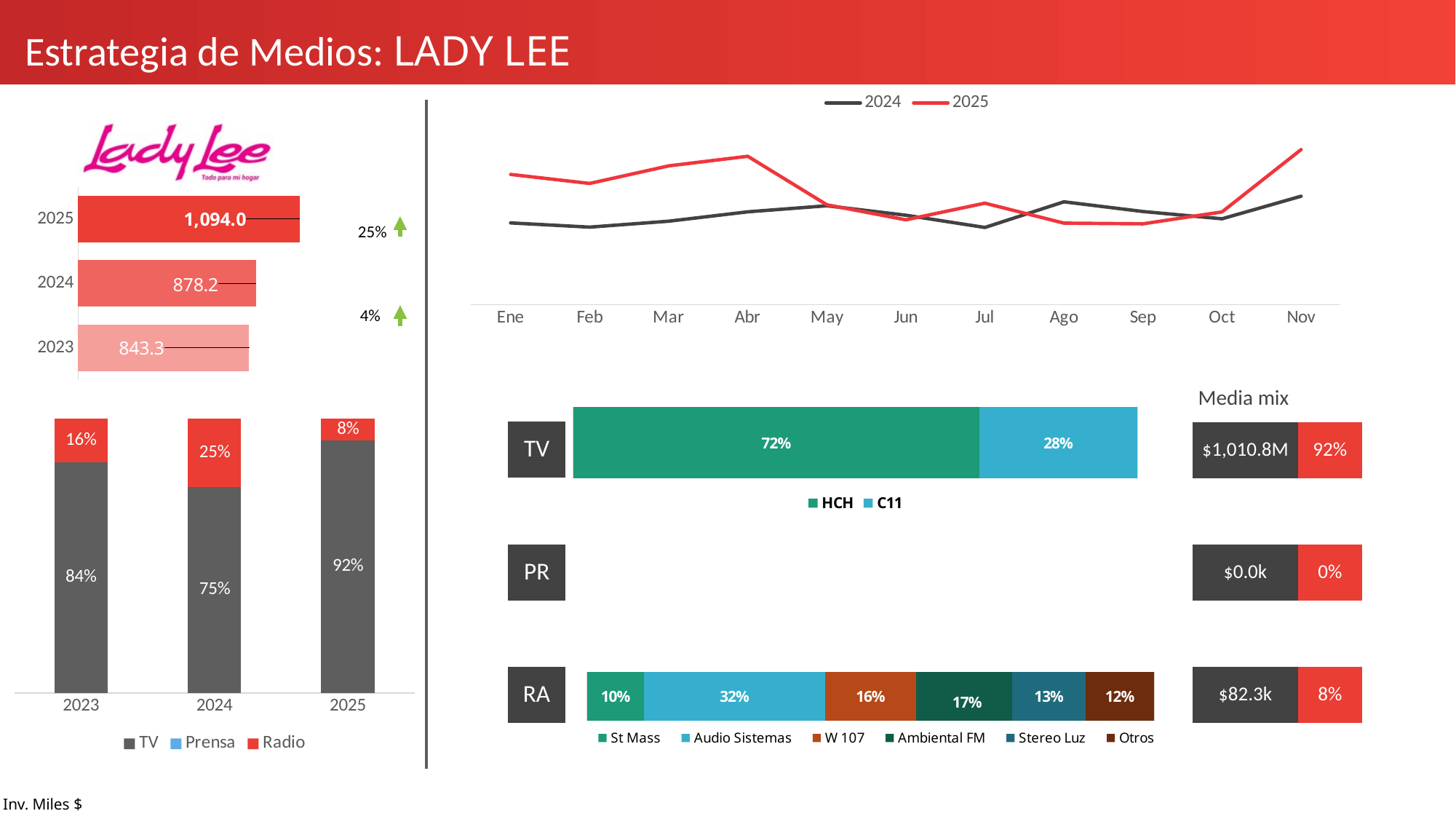
In the stacked bar chart at the bottom left, what is the Radio share for 2025? 8% In the horizontal bar chart at the top left, which year has the highest value? 2025 In the stacked bar chart at the bottom left, how many series does the legend list? 3 In the horizontal bar chart at the top left, what is the value for 2023? 843.3 In the horizontal bar chart at the top left, what is the difference between the 2025 and 2024 values? 215.8 In the Media mix column, what is the investment amount shown for RA? $82.3k In the line chart at the top right, which series is drawn in red? 2025 In the line chart at the top right, how many months are shown on the x axis? 11 In the horizontal bar chart at the top left, what is the value for 2025? 1,094.0 In the TV bar on the right, what is the share for HCH? 72% In the stacked bar chart at the bottom left, what is the TV share for 2024? 75% In the RA bar on the right, which station has the largest share? Audio Sistemas